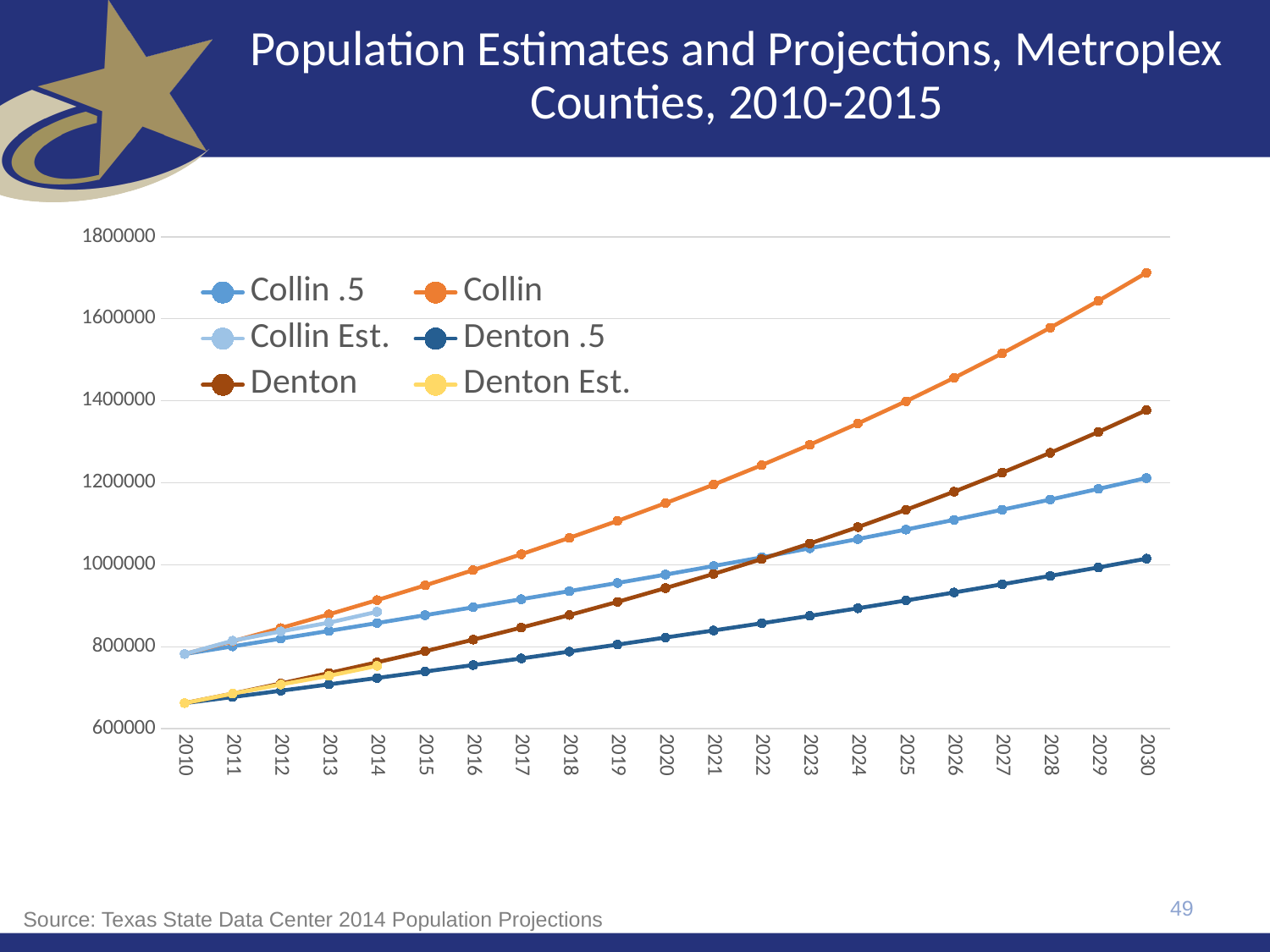
What kind of chart is shown on the slide? line chart What is the title of the chart on the slide? Population Estimates and Projections, Metroplex Counties, 2010-2015 Which series has the lowest value in 2030? Denton .5 Is the value for Denton in 2020 greater or less than 1000000? less Which is larger in 2030, the value for Collin or the value for Denton? Collin Does the Collin series rise or fall from 2010 to 2030? rise Is the value for Collin in 2030 greater or less than 1600000? greater Which series has the highest value in 2030? Collin How many series does the chart legend list? 6 Is the value for Collin in 2020 greater or less than 1200000? less Which is larger in 2030, the value for Collin .5 or the value for Denton? Denton How many years are shown along the x axis of the chart? 21